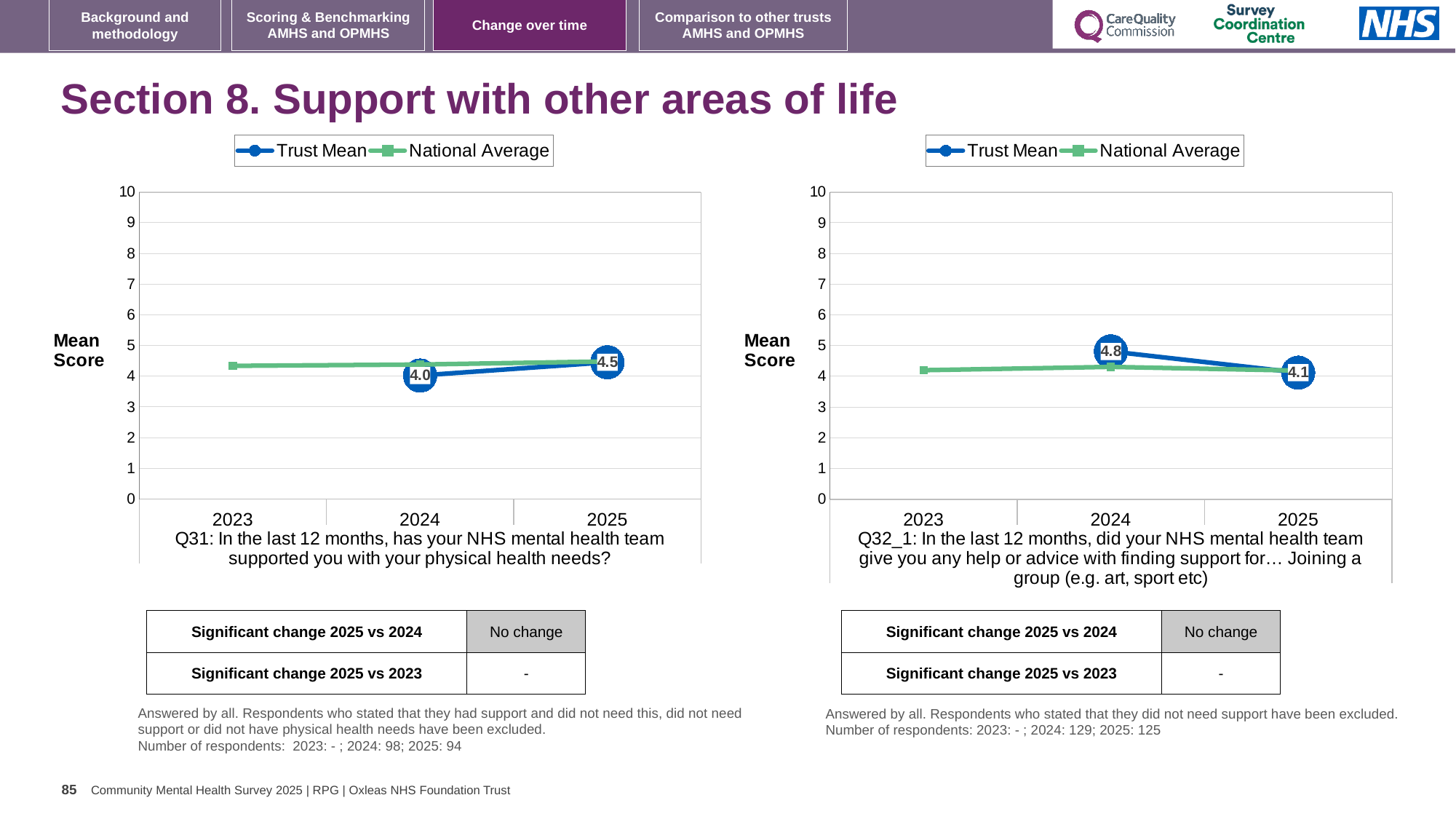
On the right chart (Q32_1), what is the Trust Mean for 2024? 4.8 On the right chart (Q32_1), does the Trust Mean rise or fall from 2024 to 2025? fall On the left chart (Q31), does the Trust Mean rise or fall from 2024 to 2025? rise How many series does the legend of the left chart list? 2 On the left chart (Q31), is the National Average for 2023 greater or less than 5? less On the right chart (Q32_1), what is the Trust Mean for 2025? 4.1 On the left chart (Q31), what is the Trust Mean for 2024? 4.0 On the right chart (Q32_1), which year has the higher Trust Mean, 2024 or 2025? 2024 On the left chart (Q31), what is the Trust Mean for 2025? 4.5 On the right chart (Q32_1), what is the difference between the Trust Mean in 2024 and in 2025? 0.7 On the left chart (Q31), by how much did the Trust Mean change from 2024 to 2025? 0.5 What type of chart is used on the right side of the slide (Q32_1)? line chart